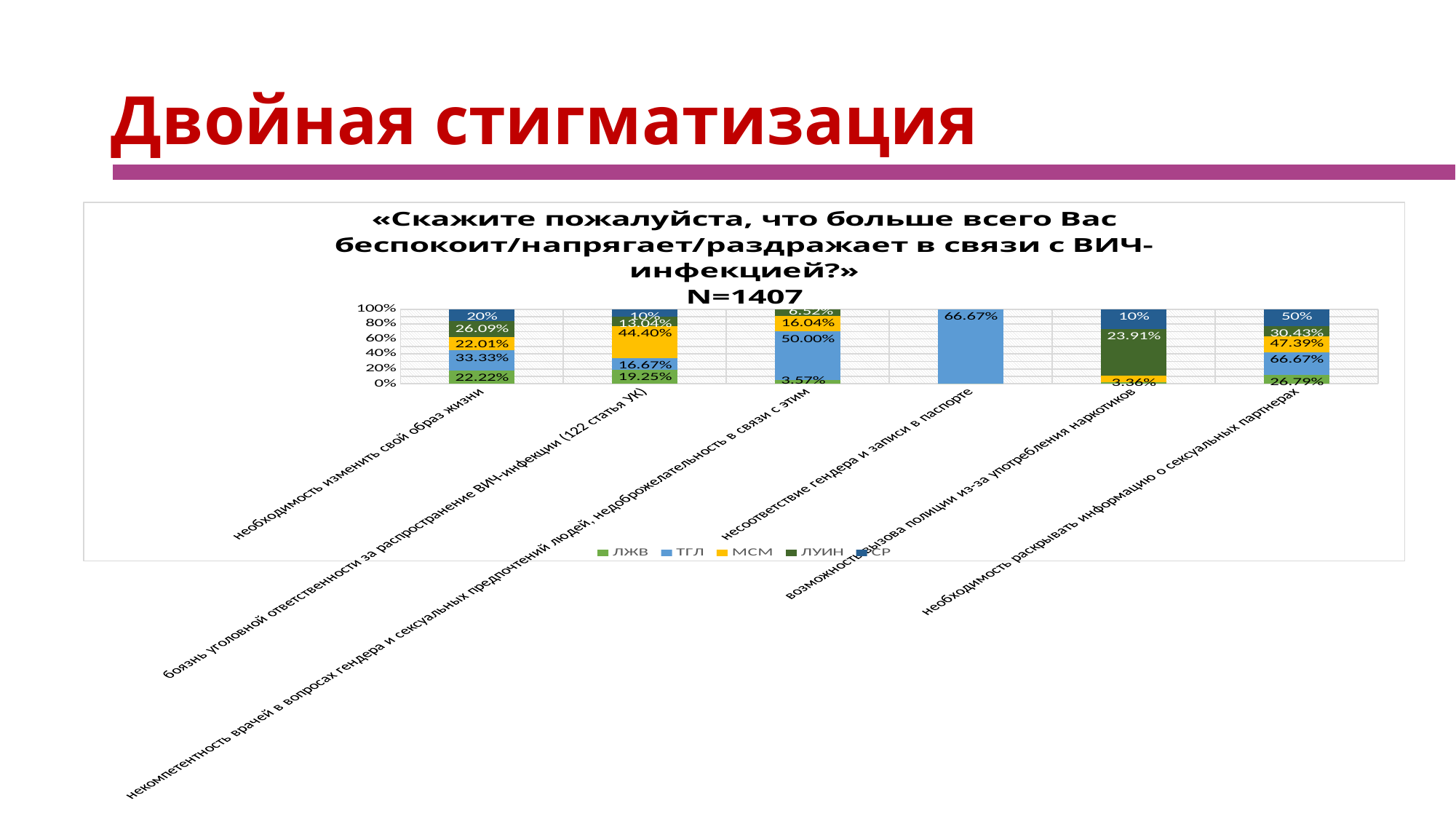
Which is larger: the ЛЖВ value for 'необходимость раскрывать информацию о сексуальных партнерах' or the ЛЖВ value for 'боязнь уголовной ответственности за распространение ВИЧ-инфекции (122 статья УК)'? необходимость раскрывать информацию о сексуальных партнерах What is the value for СР in the category 'необходимость раскрывать информацию о сексуальных партнерах'? 50% What kind of chart is shown on the slide? stacked bar chart How many series does the legend list? 5 What is the value for ЛУИН in the category 'возможность вызова полиции из-за употребления наркотиков'? 23.91% What is the value for МСМ in the category 'боязнь уголовной ответственности за распространение ВИЧ-инфекции (122 статья УК)'? 44.40% What sample size (N) is stated in the chart title? N=1407 What is the value for ЛЖВ in the category 'необходимость изменить свой образ жизни'? 22.22% What is the value for ТГЛ in the category 'некомпетентность врачей в вопросах гендера и сексуальных предпочтений людей, недоброжелательность в связи с этим'? 50.00% What is the difference between the МСМ value for 'необходимость раскрывать информацию о сексуальных партнерах' (47.39%) and the МСМ value for 'необходимость изменить свой образ жизни' (22.01%)? 25.38% What is the value for ТГЛ in the category 'несоответствие гендера и записи в паспорте'? 66.67% How many categories are shown on the x axis? 6